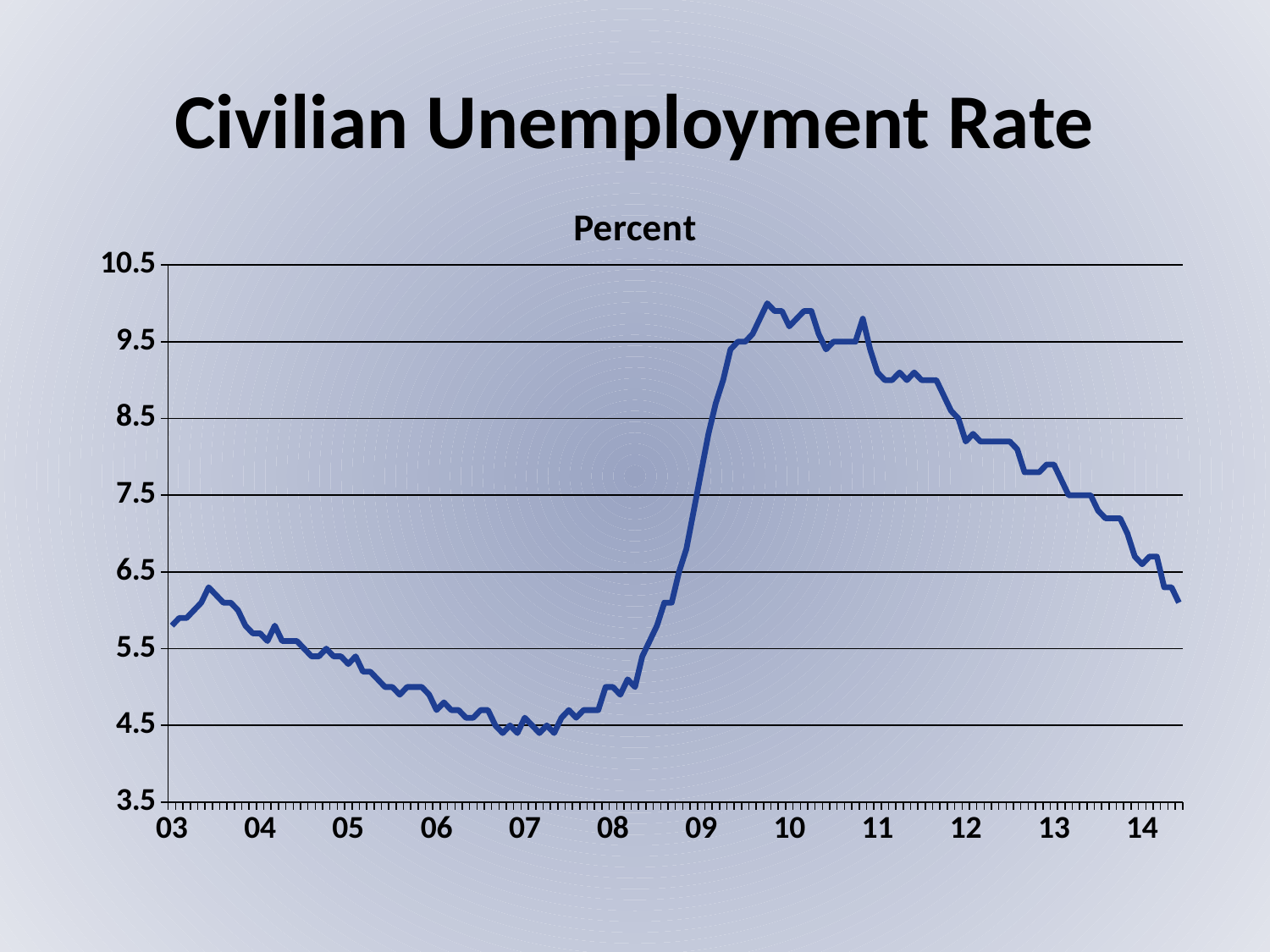
Does the unemployment rate rise or fall between 11 and 14? fall Is the unemployment rate at the start of 03 greater or less than 5.5? greater Is the unemployment rate at the start of 14 greater or less than 7.5? less Is the unemployment rate at the start of 08 greater or less than 5.5? less What is the title of the chart? Civilian Unemployment Rate What kind of chart is shown on the slide? line chart Is the unemployment rate higher at the start of 10 or at the start of 07? 10 Does the unemployment rate rise or fall between 09 and 10? rise How many year labels are shown along the x axis? 12 What unit label is shown above the chart's plot area? Percent